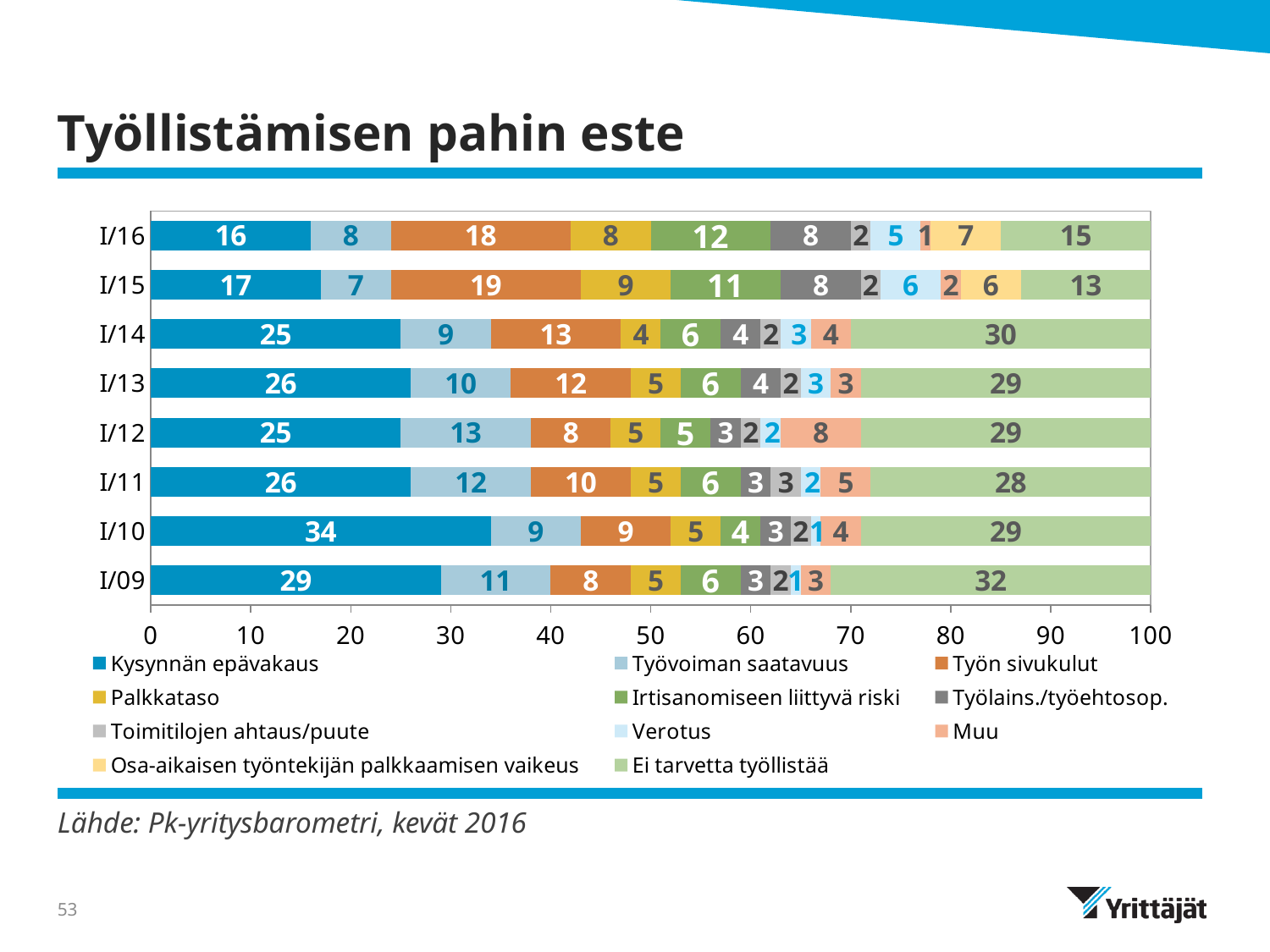
Which year has the highest value for Kysynnän epävakaus? I/10 How many years (categories) are shown on the chart? 8 What is the difference between the Kysynnän epävakaus values for I/10 and I/09? 5 How many series does the legend list? 11 Which year has the lowest value for Kysynnän epävakaus? I/16 Which is larger, the Työvoiman saatavuus value for I/12 or for I/16? I/12 What is the value of Kysynnän epävakaus for I/10? 34 What kind of chart is shown on the slide? Stacked bar chart What is the value of Työn sivukulut for I/15? 19 What is the total of the stacked bar for I/16? 100 What is the value of Ei tarvetta työllistää for I/09? 32 What is the title of the chart? Työllistämisen pahin este